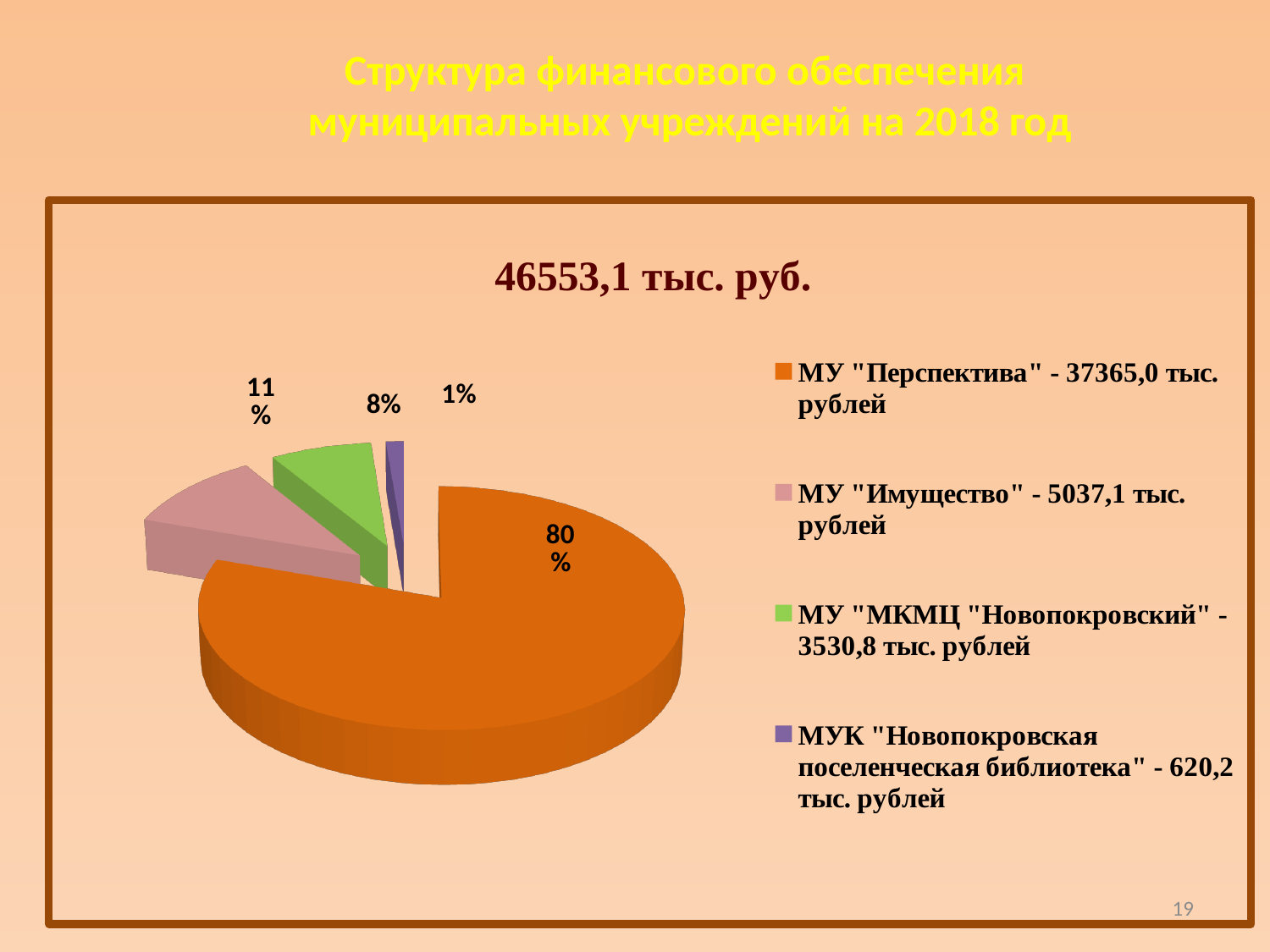
What kind of chart is shown on the slide? pie chart What total amount is shown as the title of the pie chart? 46553,1 тыс. руб. How many entries does the legend of the pie chart list? 4 How many slices does the pie chart have? 4 What amount is listed in the legend for МУ "Имущество"? 5037,1 тыс. рублей Which has a larger share in the pie chart: МУ "Имущество" or МУ "МКМЦ "Новопокровский"? МУ "Имущество" What percentage share does МУК "Новопокровская поселенческая библиотека" have in the pie chart? 1% What percentage share does МУ "Перспектива" have in the pie chart? 80% Which category has the smallest slice in the pie chart? МУК "Новопокровская поселенческая библиотека" Which category has the largest slice in the pie chart? МУ "Перспектива" What percentage share does МУ "Имущество" have in the pie chart? 11%